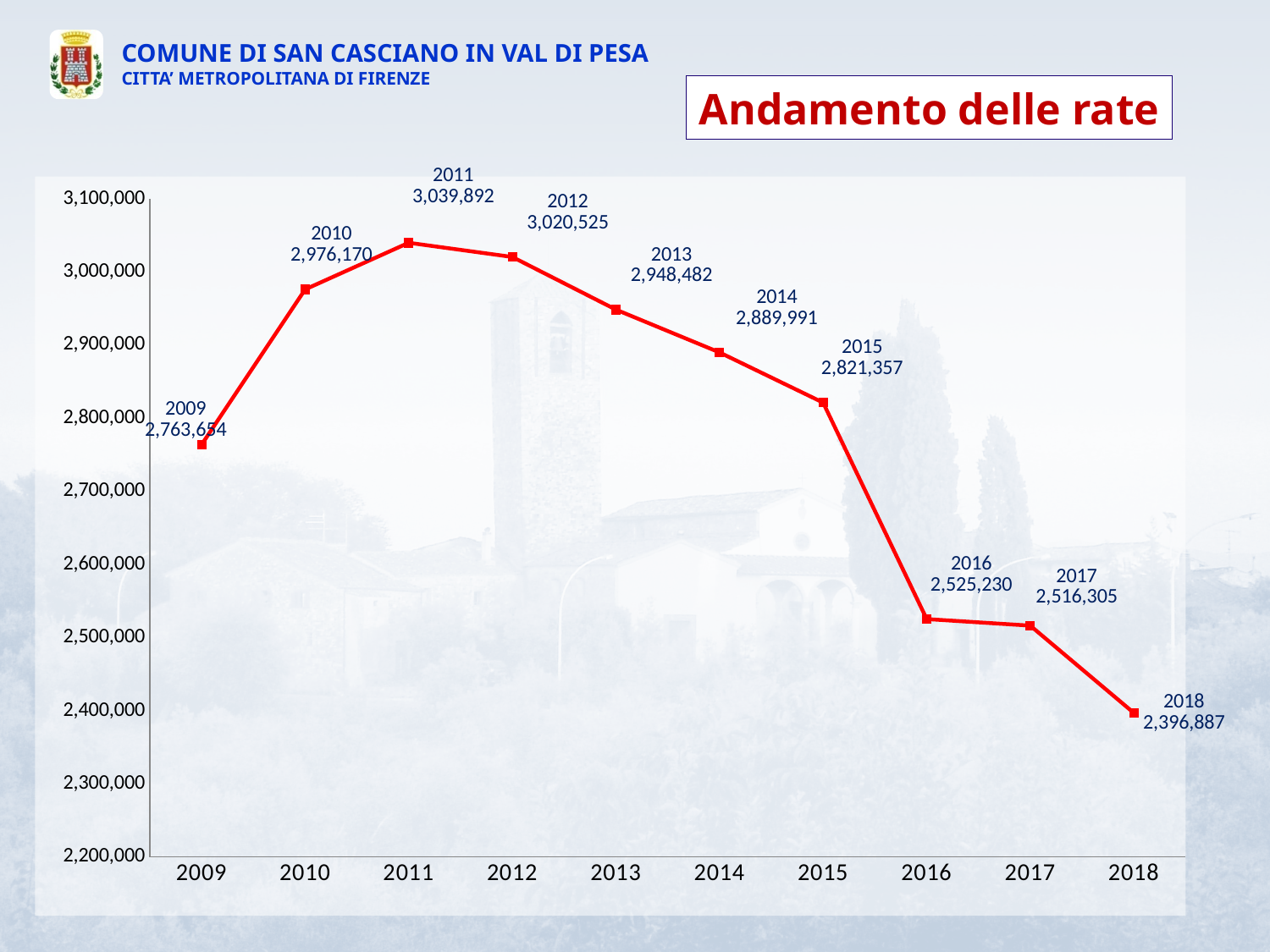
Is the value for 2009 greater or less than 2,800,000? less Which year has the highest value? 2011 How many years are plotted on the chart? 10 What kind of chart is shown on the slide? line chart What is the difference between the values for 2015 and 2016? 296,127 What is the value for 2015? 2,821,357 What is the value for 2018? 2,396,887 What is the difference between the values for 2011 and 2012? 19,367 What is the value for 2011? 3,039,892 Which is larger, the value for 2010 or the value for 2014? 2010 Which year has the lowest value? 2018 What is the value for 2013? 2,948,482